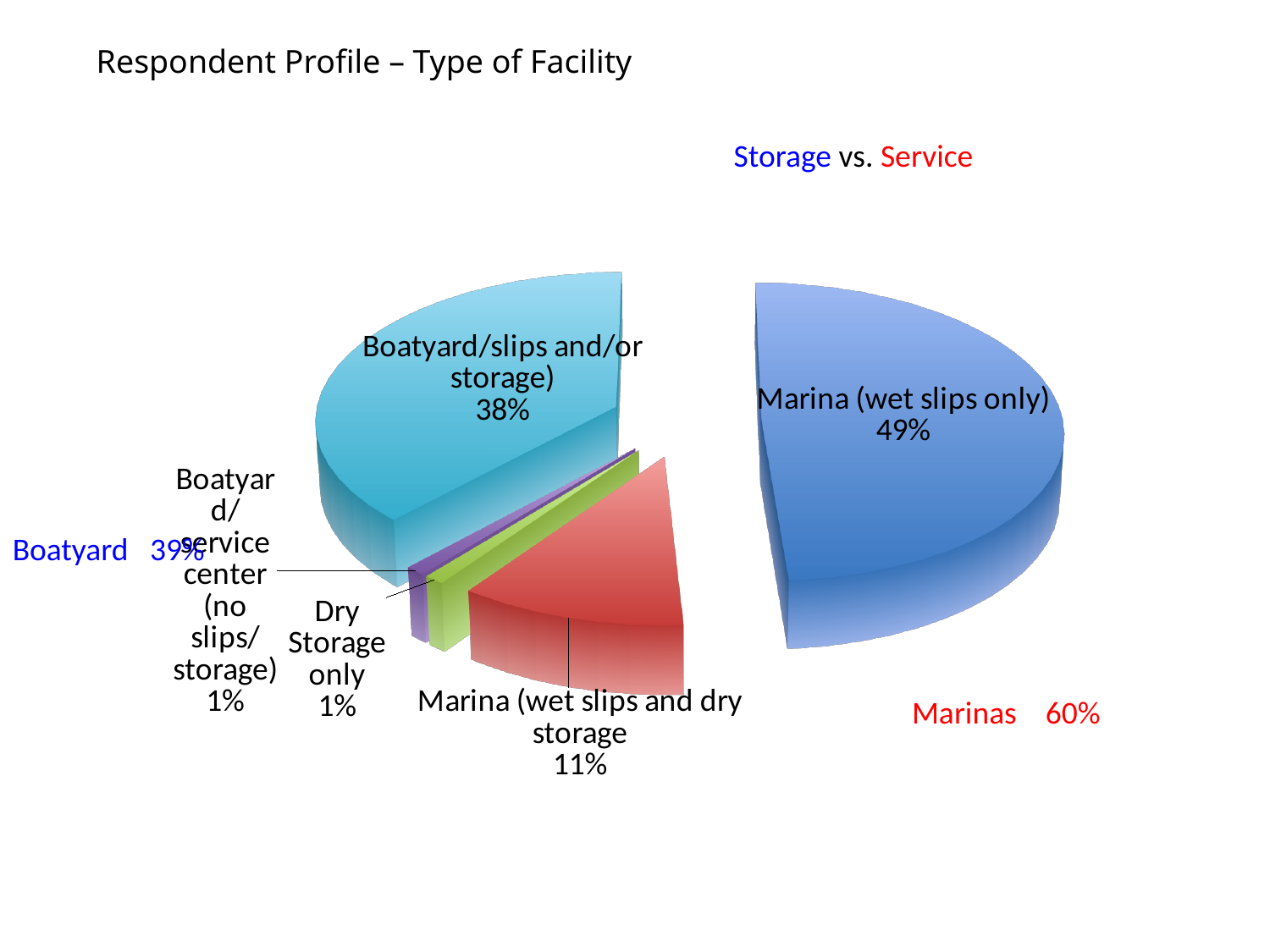
What is the title of the slide? Respondent Profile – Type of Facility Which type of facility has the largest share of the pie? Marina (wet slips only) How many slices does the pie chart have? 5 What share of respondents are Marina (wet slips only)? 49% What share of respondents are Boatyard/service center (no slips/storage)? 1% According to the annotation on the slide, what combined percentage is given for Marinas? 60% What kind of chart is shown on the slide? pie chart What share of respondents are Boatyard/slips and/or storage? 38% What is the difference in percentage points between Marina (wet slips only) and Boatyard/slips and/or storage? 11 What share of respondents are Marina (wet slips and dry storage)? 11% What share of respondents are Dry Storage only? 1% Which is larger, the share for Boatyard/slips and/or storage or the share for Marina (wet slips and dry storage)? Boatyard/slips and/or storage